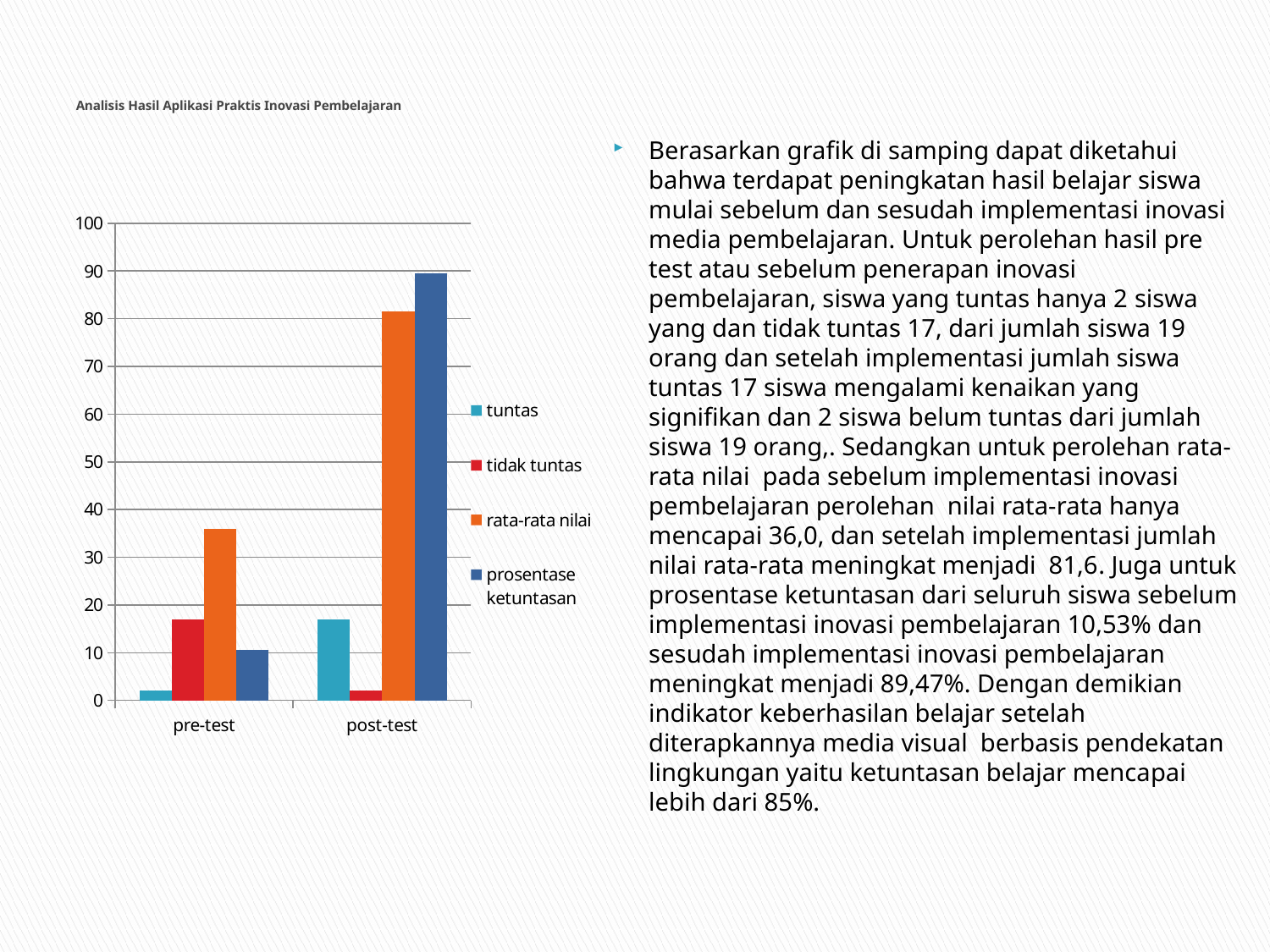
Is the value for rata-rata nilai in post-test greater or less than 70? greater What kind of chart is shown on the slide? bar chart Which series has the highest bar in the pre-test category? rata-rata nilai Which is larger, the tuntas value for pre-test or for post-test? post-test Does the rata-rata nilai series rise or fall from pre-test to post-test? rise Is the value for rata-rata nilai in pre-test greater or less than 30? greater Is the value for prosentase ketuntasan in pre-test greater or less than 20? less What colour represents the tidak tuntas series in the chart? red Which series has the lowest bar in the post-test category? tidak tuntas Which series has the highest bar in the post-test category? prosentase ketuntasan How many series does the chart's legend list? 4 How many categories are shown on the x axis of the chart? 2